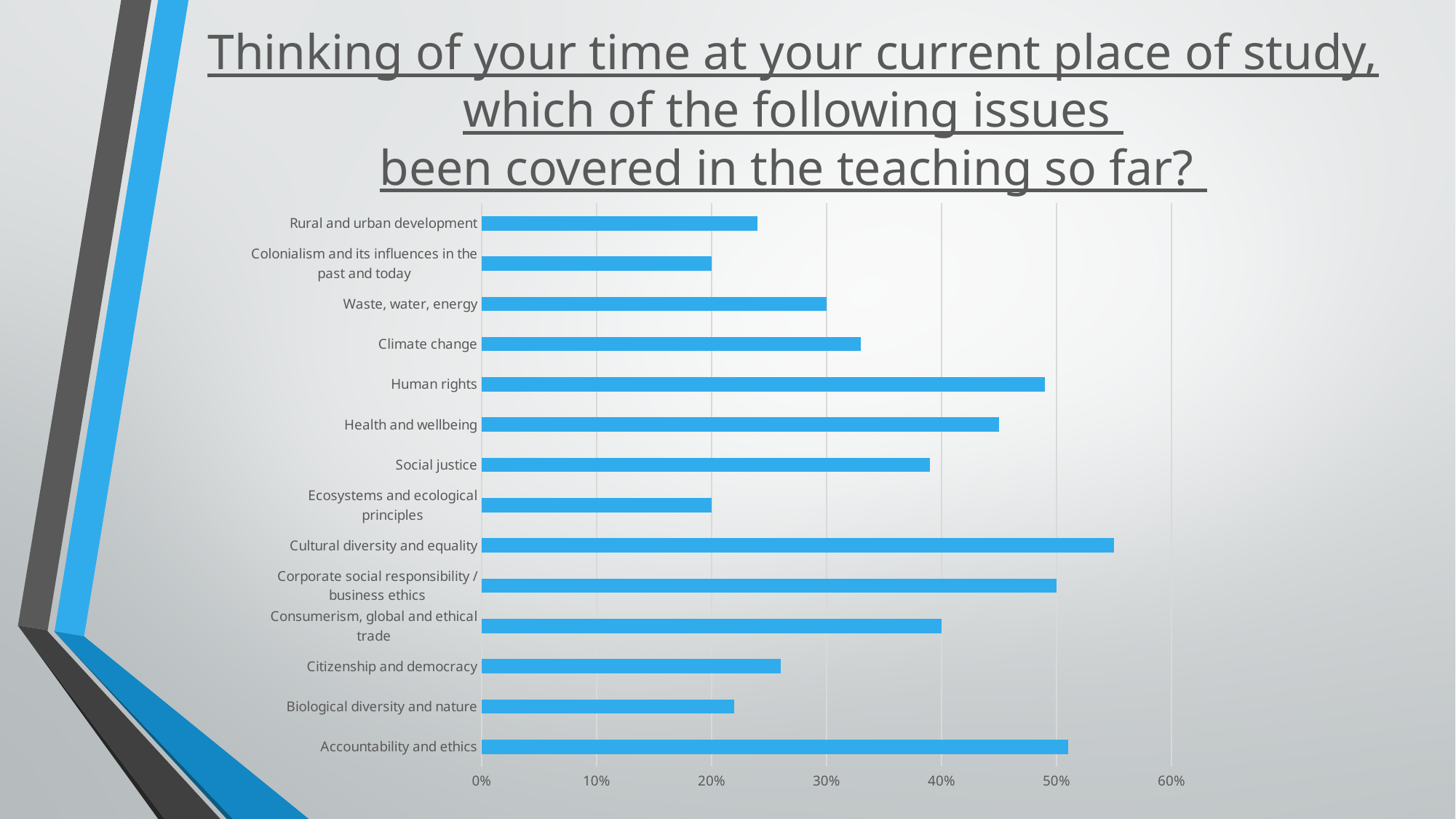
What kind of chart is shown on the slide? Bar chart Is the value for Rural and urban development greater or less than 30%? less What is the value for Consumerism, global and ethical trade? 40% What is the value for Waste, water, energy? 30% Is the value for Climate change greater or less than 30%? greater What is the highest percentage tick shown on the horizontal axis? 60% How many issues (categories) are listed on the chart? 14 Which issue has the highest percentage on the chart? Cultural diversity and equality What is the value for Corporate social responsibility / business ethics? 50% Which is larger, the value for Human rights or the value for Health and wellbeing? Human rights